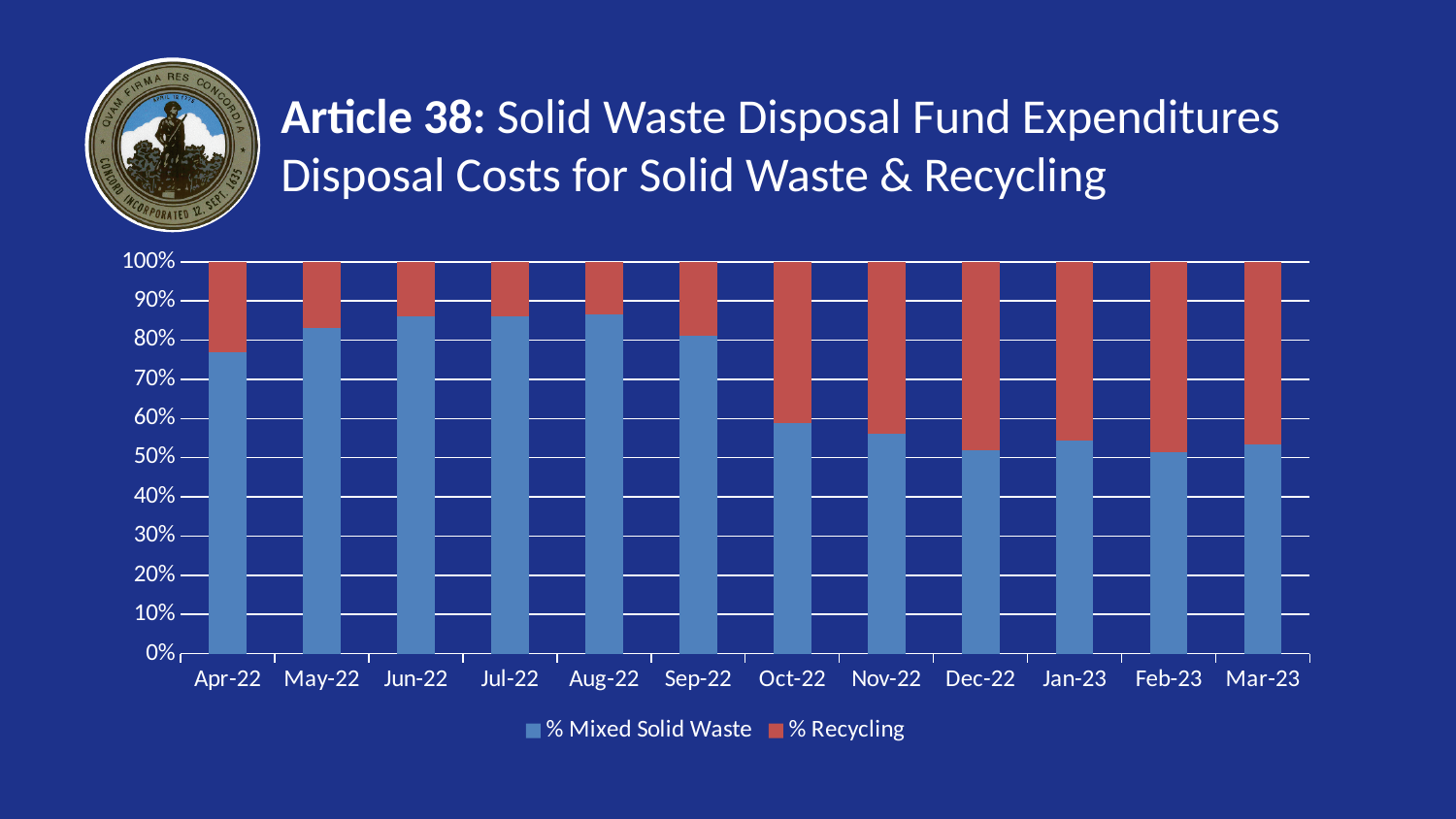
Which month has the larger % Mixed Solid Waste share, Apr-22 or Oct-22? Apr-22 How many series does the chart's legend list? 2 Is the % Mixed Solid Waste share for Jun-22 greater or less than 80%? greater What are the two series named in the legend? % Mixed Solid Waste and % Recycling Which colour represents % Recycling in the chart? Red Which month has the larger % Recycling share, Sep-22 or Dec-22? Dec-22 Is the % Mixed Solid Waste share for Nov-22 greater or less than 60%? less From Sep-22 to Dec-22, does the % Mixed Solid Waste share rise or fall? Fall How many months are shown along the x axis of the chart? 12 Is the % Mixed Solid Waste share for Apr-22 greater or less than 70%? greater What kind of chart is shown on the slide? Stacked bar chart